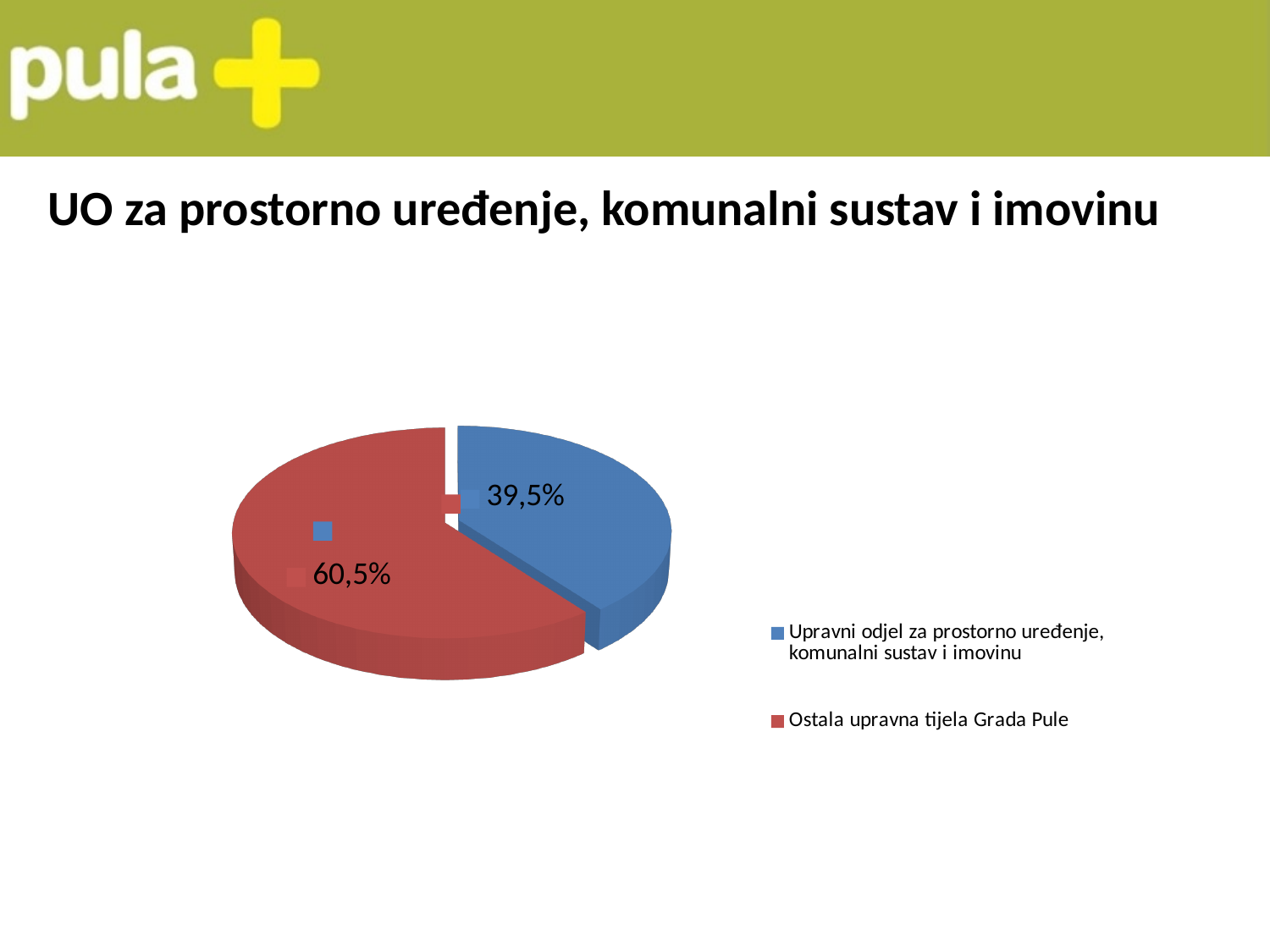
What kind of chart is shown on the slide? pie chart How many slices does the pie chart have? 2 How many entries does the legend list? 2 What share of the pie does 'Upravni odjel za prostorno uređenje, komunalni sustav i imovinu' have? 39,5% Which slice is the largest? Ostala upravna tijela Grada Pule What is the difference in percentage points between the 'Ostala upravna tijela Grada Pule' slice and the 'Upravni odjel za prostorno uređenje, komunalni sustav i imovinu' slice? 21 percentage points Which is larger: the share for 'Ostala upravna tijela Grada Pule' or the share for 'Upravni odjel za prostorno uređenje, komunalni sustav i imovinu'? Ostala upravna tijela Grada Pule Which slice is the smallest? Upravni odjel za prostorno uređenje, komunalni sustav i imovinu What colour is the slice for 'Ostala upravna tijela Grada Pule'? red What share of the pie does 'Ostala upravna tijela Grada Pule' have? 60,5% What is the title shown above the chart? UO za prostorno uređenje, komunalni sustav i imovinu